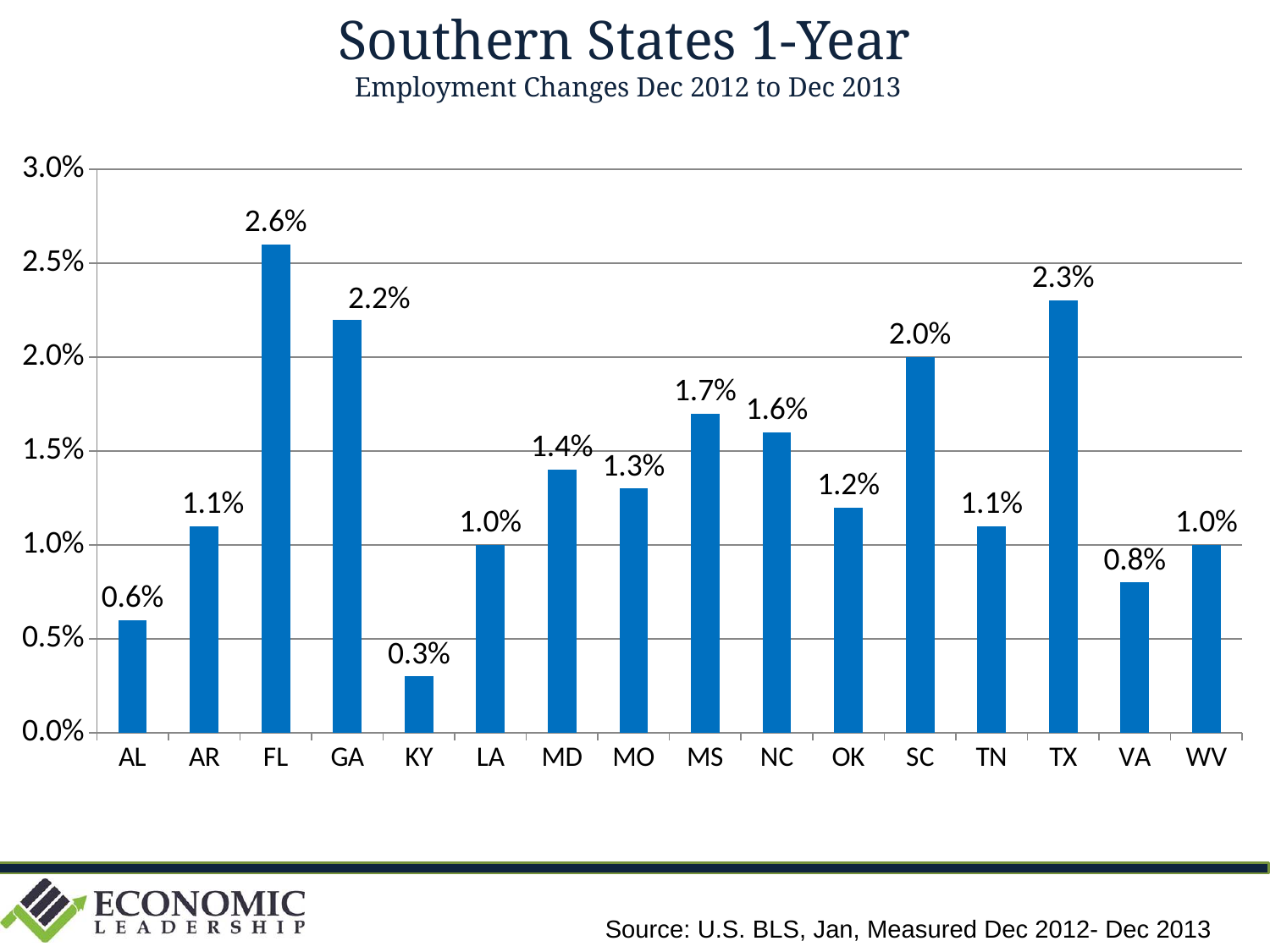
What is the employment change value for SC? 2.0% Which state has the highest employment change? FL What is the employment change value for KY? 0.3% What kind of chart is shown on the slide? bar chart What is the subtitle of the chart? Employment Changes Dec 2012 to Dec 2013 Which state has the lowest employment change? KY How many states are shown on the chart? 16 What is the difference between the values for MS and AL? 1.1% Which is larger, the value for NC or the value for OK? NC What is the difference between the values for TX and GA? 0.1% What is the employment change value for FL? 2.6% Is the value for VA greater or less than 1.0%? less